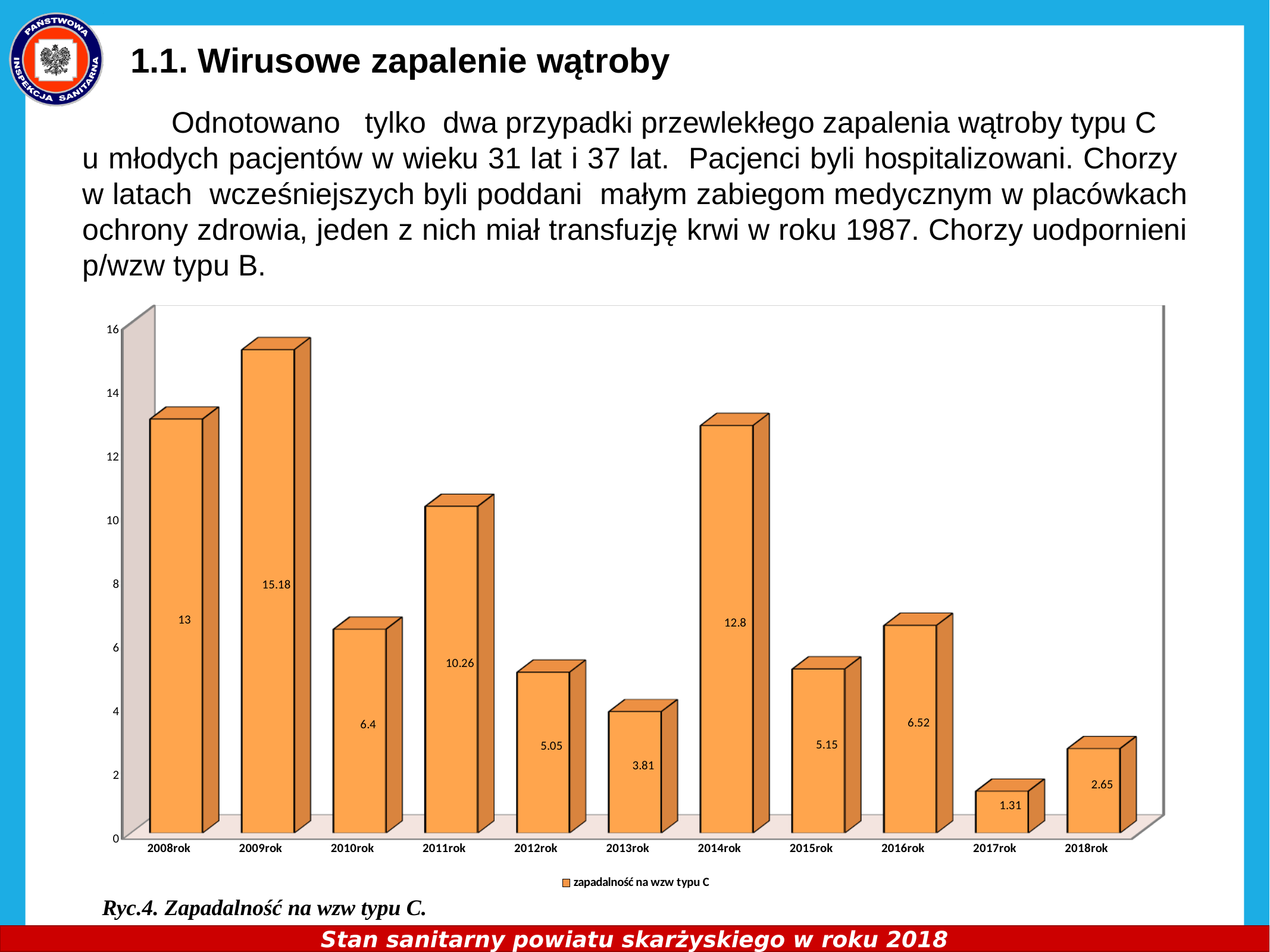
What is the legend entry for the series? zapadalność na wzw typu C What kind of chart is shown? bar chart What is the value for 2009rok? 15.18 Is the value for 2013rok greater or less than 4? less Which is larger, the value for 2011rok or the value for 2016rok? 2011rok What is the difference between the values for 2008rok and 2010rok? 6.6 What is the value for 2014rok? 12.8 Which year has the highest value? 2009rok Which year has the lowest value? 2017rok What is the value for 2018rok? 2.65 How many years are shown on the x axis? 11 How many series does the legend list? 1